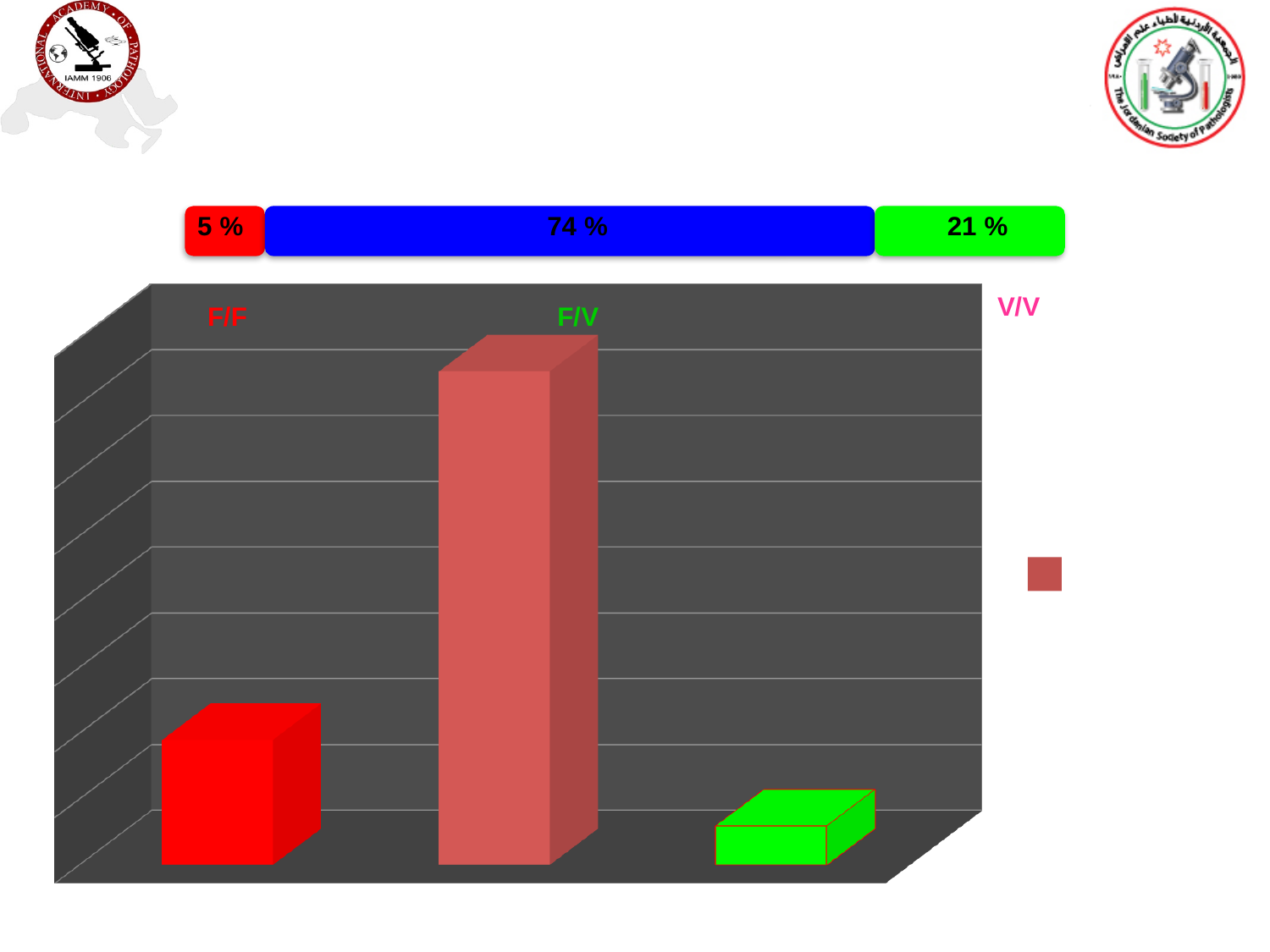
In the bar chart, which bar is taller, F/F or F/V? F/V Which category has the shortest bar in the bar chart? V/V What colour is the V/V bar in the bar chart? green In the horizontal stacked bar at the top of the slide, what percentage is shown in the blue segment? 74 % How many bars are plotted in the bar chart? 3 What are the three category labels shown on the bar chart? F/F, F/V, V/V In the horizontal stacked bar at the top of the slide, what is the difference between the blue segment and the green segment? 53 % What kind of chart is the large chart in the lower part of the slide? bar chart What is the total of the three segments in the horizontal stacked bar at the top of the slide? 100 % In the bar chart, which bar is taller, F/F or V/V? F/F Which category has the tallest bar in the bar chart? F/V In the horizontal stacked bar at the top of the slide, what percentage is shown in the red segment? 5 %